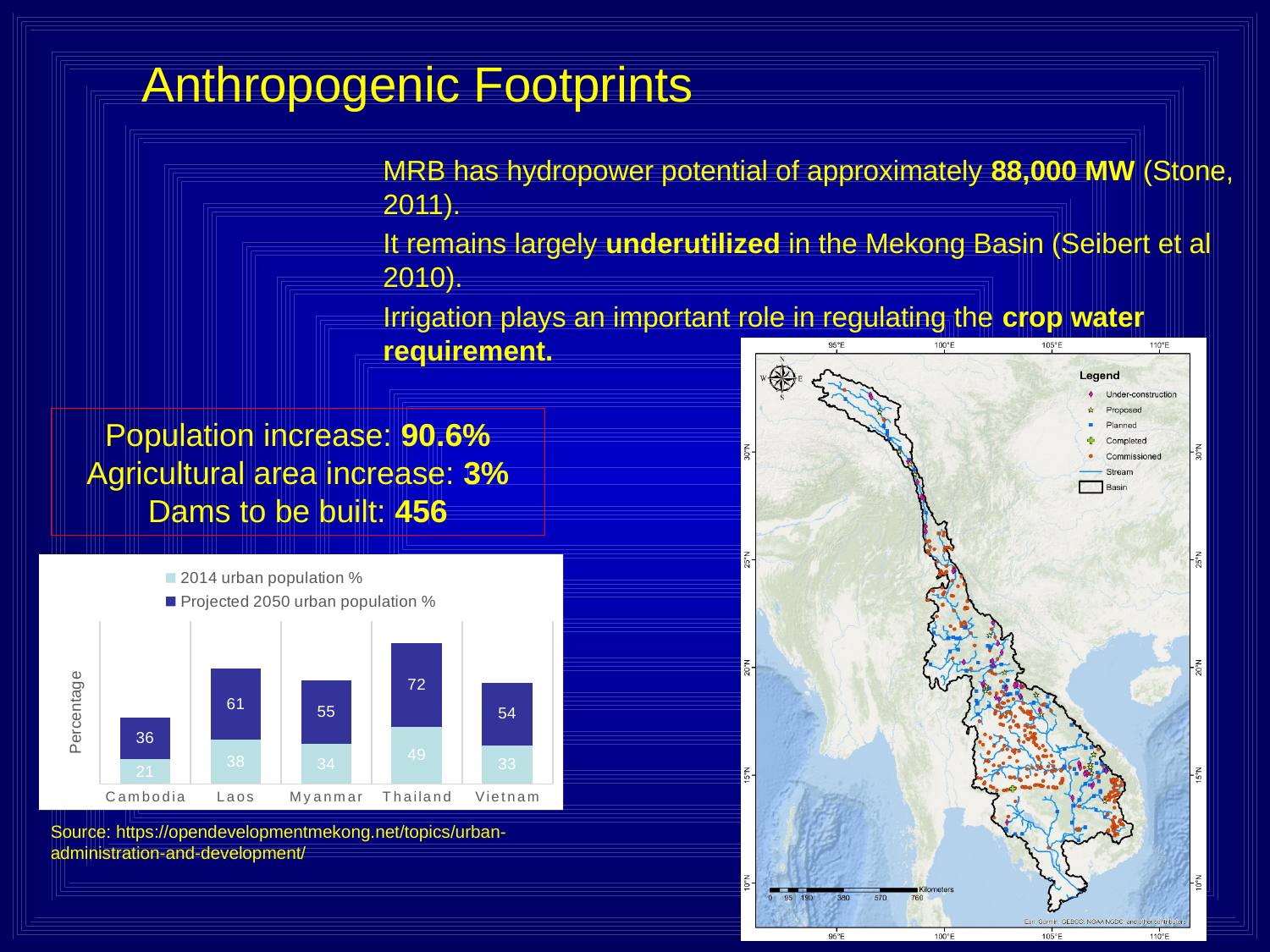
What kind of chart is shown on the slide? Stacked bar chart Which country has the highest projected 2050 urban population %? Thailand Which is larger, the 2014 urban population % for Laos or for Myanmar? Laos How many series does the chart legend list? 2 Which country has the lowest 2014 urban population %? Cambodia What is the projected 2050 urban population % for Laos? 61 How many countries are shown on the x axis of the chart? 5 What is the 2014 urban population % for Cambodia? 21 What is the projected 2050 urban population % for Thailand? 72 What is the difference between the projected 2050 and the 2014 urban population % for Myanmar? 21 What is the total of the stacked bar for Thailand? 121 What is the 2014 urban population % for Vietnam? 33